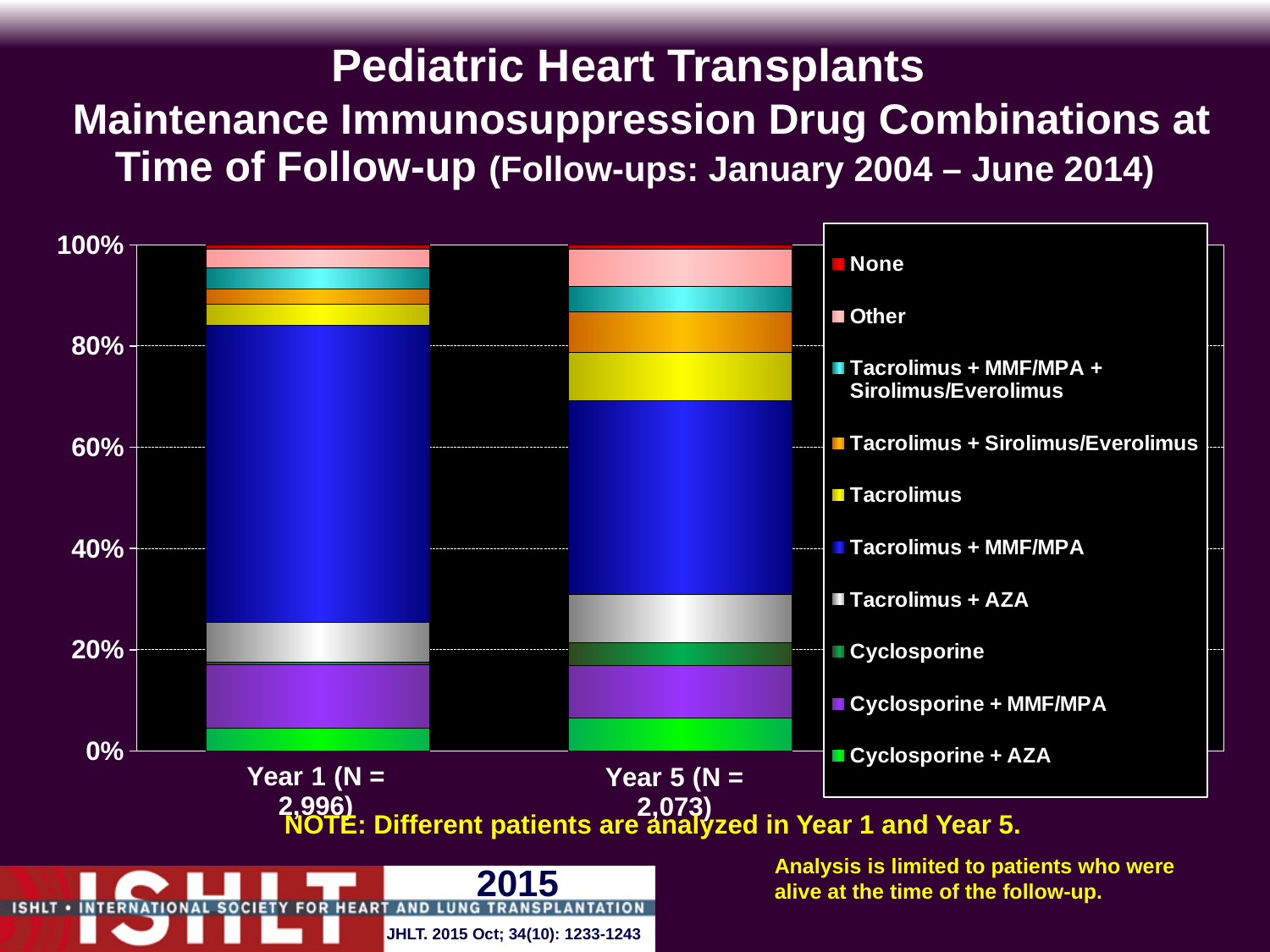
Is the Tacrolimus + Sirolimus/Everolimus segment larger in Year 1 or in Year 5? Year 5 How many bars (follow-up time points) are plotted in the chart? 2 Which drug combination makes up the largest share of the Year 5 bar? Tacrolimus + MMF/MPA Is the Tacrolimus + MMF/MPA share in Year 1 greater or less than 40%? greater What is the number of patients (N) shown for the Year 5 bar? 2,073 Which drug combination makes up the largest share of the Year 1 bar? Tacrolimus + MMF/MPA What is the total height of the Year 1 stacked bar? 100% What kind of chart is shown on the slide? Stacked bar chart Is the Tacrolimus (alone) segment larger in Year 1 or in Year 5? Year 5 How many drug combination series does the legend list? 10 Is the Tacrolimus + MMF/MPA segment larger in Year 1 or in Year 5? Year 1 Which legend entry is shown in red? None